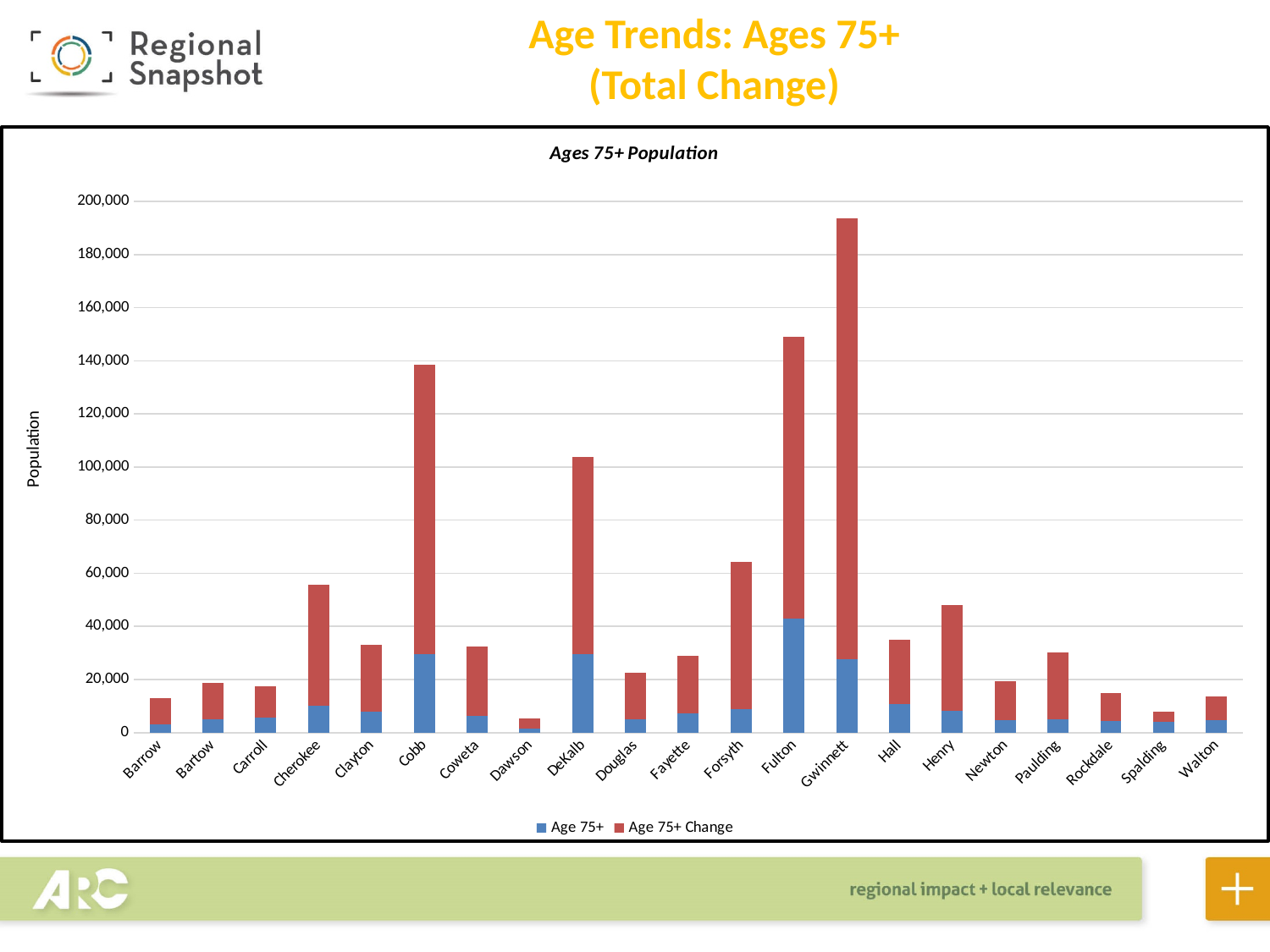
What is the title of the chart? Ages 75+ Population Which county has a taller total bar, Cobb or DeKalb? Cobb What kind of chart is shown on the slide? Stacked bar chart What are the two series named in the chart's legend? Age 75+ and Age 75+ Change Is the total bar for Gwinnett greater or less than 180,000? greater How many counties are shown along the x axis of the chart? 21 Is the total bar for Cherokee greater or less than 60,000? less Which county has a taller total bar, Fulton or Gwinnett? Gwinnett Is the total bar for Fulton greater or less than 140,000? greater Which county has the shortest total bar in the chart? Dawson Which county has the tallest total bar in the chart? Gwinnett How many series does the chart's legend list? 2